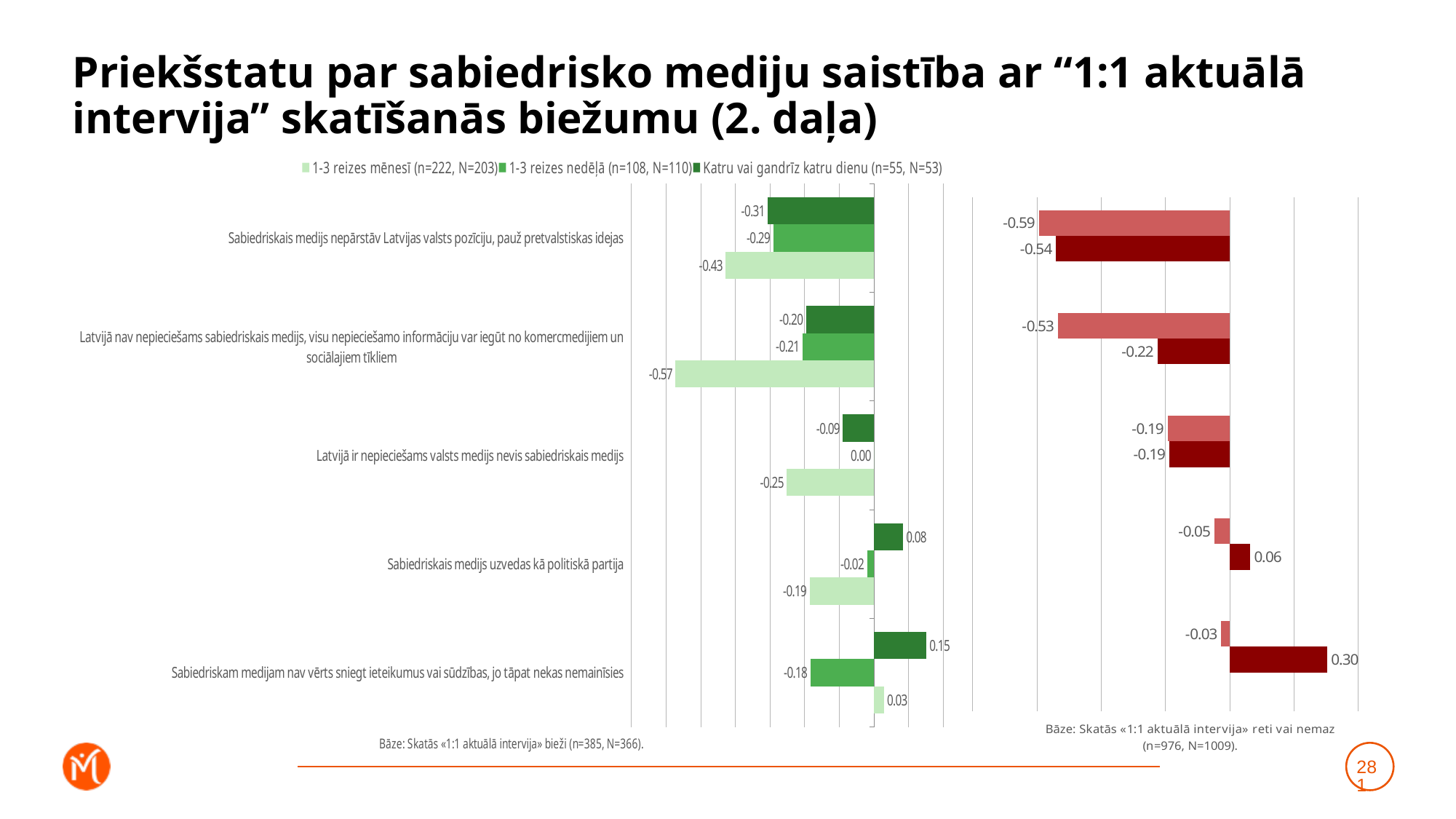
In the left chart (base: skatās bieži), what is the value for '1-3 reizes mēnesī' for the statement 'Latvijā nav nepieciešams sabiedriskais medijs, visu nepieciešamo informāciju var iegūt no komercmedijiem un sociālajiem tīkliem'? -0.57 In the left chart (base: skatās bieži), for the statement 'Sabiedriskais medijs uzvedas kā politiskā partija', which is larger: the value for 'Katru vai gandrīz katru dienu' or the value for '1-3 reizes mēnesī'? Katru vai gandrīz katru dienu What kind of chart is the left chart (base: skatās bieži)? Bar chart In the right chart (base: skatās reti vai nemaz), what is the value of the lighter red bar for the statement 'Sabiedriskais medijs nepārstāv Latvijas valsts pozīciju, pauž pretvalstiskas idejas'? -0.59 In the right chart (base: skatās reti vai nemaz), what is the value of the dark red bar for the statement 'Sabiedriskam medijam nav vērts sniegt ieteikumus vai sūdzības, jo tāpat nekas nemainīsies'? 0.30 In the left chart (base: skatās bieži), what is the value for '1-3 reizes nedēļā' for the statement 'Latvijā ir nepieciešams valsts medijs nevis sabiedriskais medijs'? 0.00 In the left chart (base: skatās bieži), how many statements (categories) are shown? 5 In the left chart (base: skatās bieži), what is the value for 'Katru vai gandrīz katru dienu' for the statement 'Sabiedriskais medijs nepārstāv Latvijas valsts pozīciju, pauž pretvalstiskas idejas'? -0.31 In the left chart (base: skatās bieži), how many series does the legend list? 3 In the left chart (base: skatās bieži), what is the difference between the '1-3 reizes mēnesī' value (-0.43) and the 'Katru vai gandrīz katru dienu' value (-0.31) for the statement 'Sabiedriskais medijs nepārstāv Latvijas valsts pozīciju, pauž pretvalstiskas idejas'? 0.12 In the left chart (base: skatās bieži), what is the value for 'Katru vai gandrīz katru dienu' for the statement 'Sabiedriskam medijam nav vērts sniegt ieteikumus vai sūdzības, jo tāpat nekas nemainīsies'? 0.15 In the left chart (base: skatās bieži), which statement has the lowest value for '1-3 reizes mēnesī'? Latvijā nav nepieciešams sabiedriskais medijs, visu nepieciešamo informāciju var iegūt no komercmedijiem un sociālajiem tīkliem